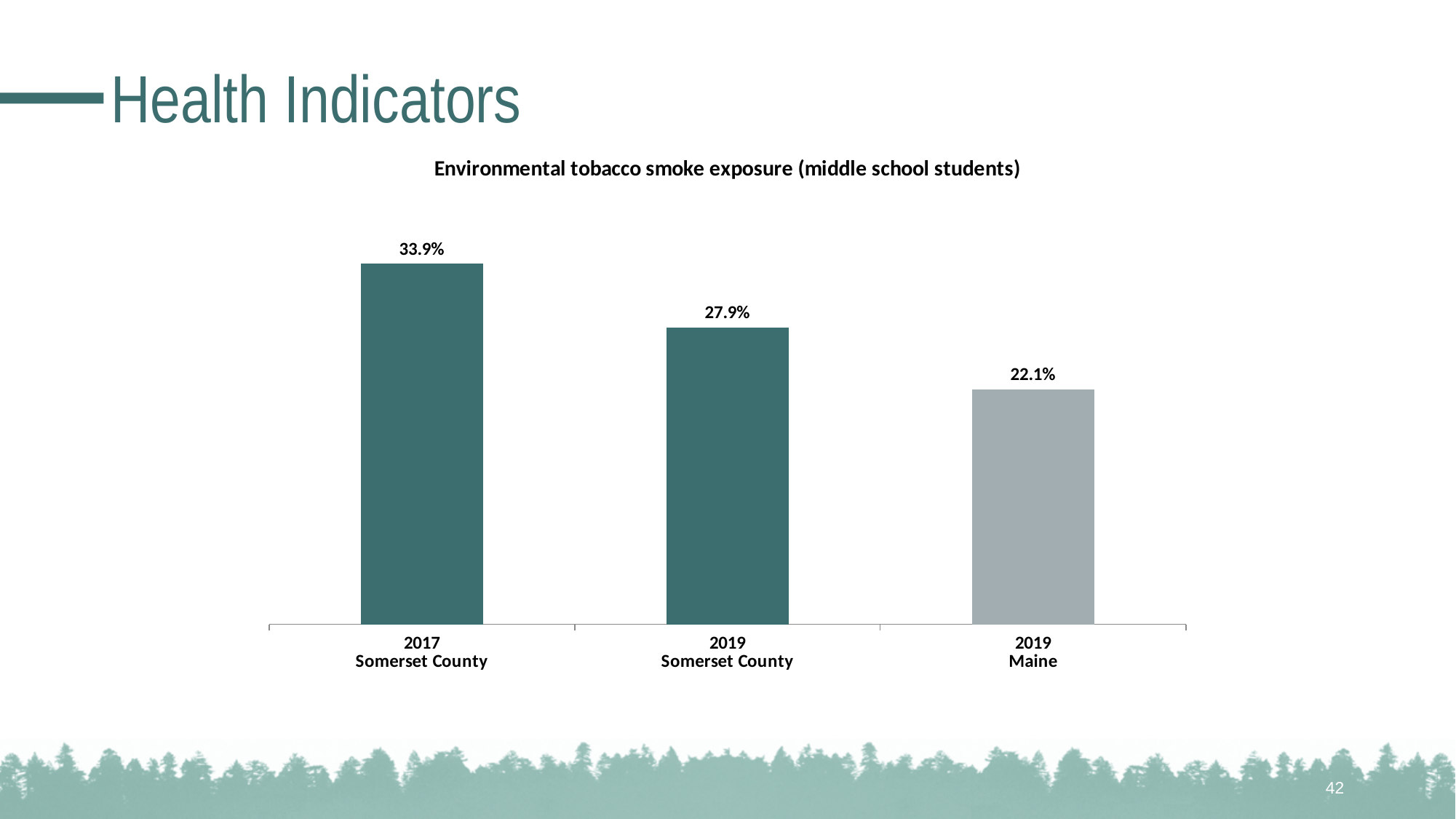
What is the difference between the 2017 Somerset County value and the 2019 Somerset County value? 6.0% What is the value for 2019 Somerset County? 27.9% What is the title of the chart? Environmental tobacco smoke exposure (middle school students) What is the difference between the 2019 Somerset County value and the 2019 Maine value? 5.8% Do the values rise or fall from left to right across the chart? Fall How many bars are shown in the chart? 3 What is the value for 2017 Somerset County? 33.9% Which is larger, the value for 2019 Somerset County or the value for 2019 Maine? 2019 Somerset County Which category has the lowest value? 2019 Maine What is the value for 2019 Maine? 22.1% What kind of chart is shown on the slide? Bar chart Which category has the highest value? 2017 Somerset County